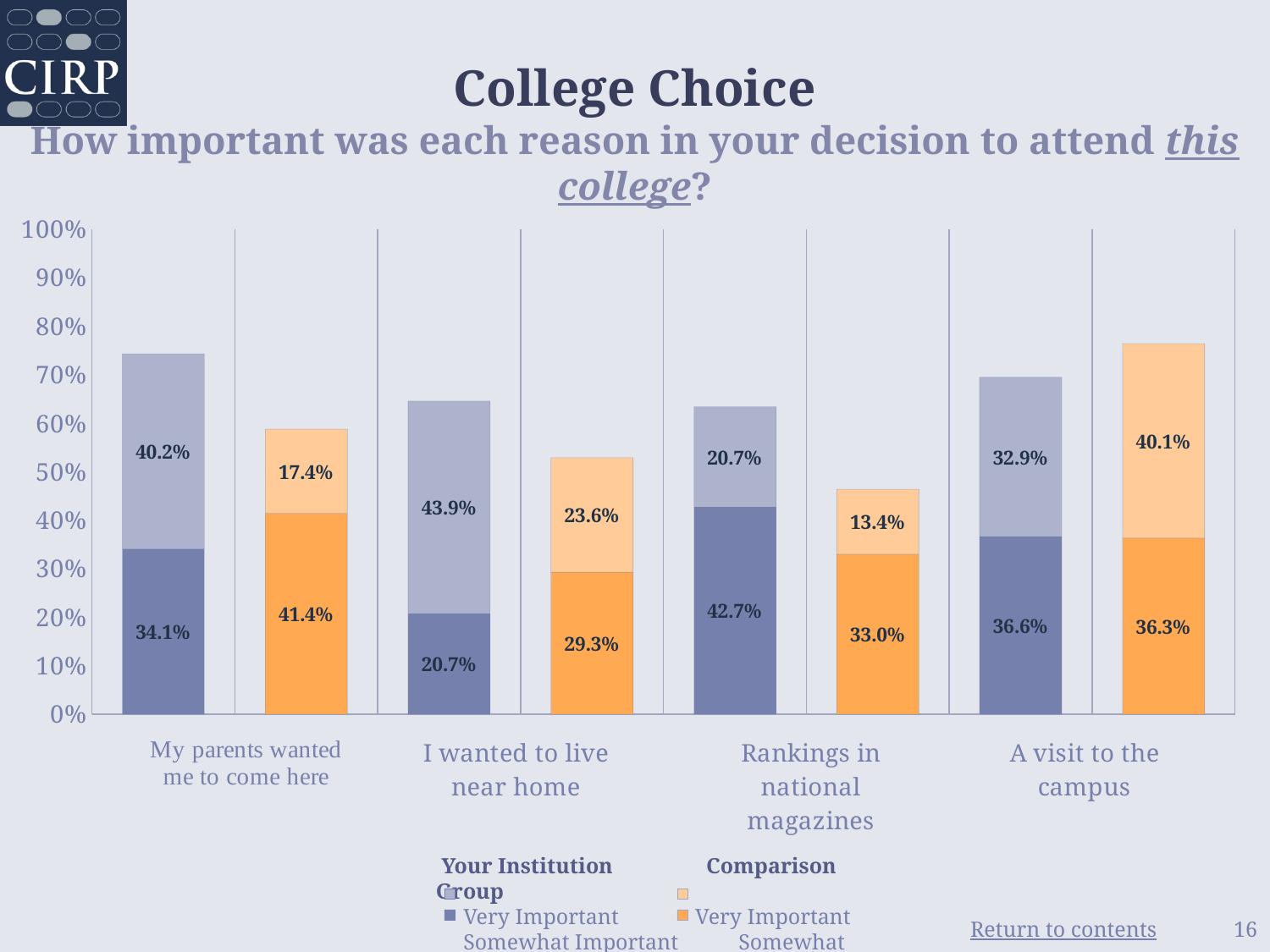
What percentage of Your Institution students rated "My parents wanted me to come here" as Very Important? 34.1% How many reasons (categories) are shown on the x axis? 4 What is the total stacked percentage (Very Important plus Somewhat Important) for Your Institution on "I wanted to live near home"? 64.6% Which reason has the lowest Somewhat Important percentage for the Comparison Group? Rankings in national magazines Which reason has the highest Very Important percentage for Your Institution? Rankings in national magazines What is the difference between the Comparison Group's and Your Institution's Very Important percentages for "My parents wanted me to come here"? 7.3% What percentage of Your Institution students rated "Rankings in national magazines" as Very Important? 42.7% What percentage of the Comparison Group rated "A visit to the campus" as Somewhat Important? 40.1% What is the total stacked percentage for the Comparison Group on "Rankings in national magazines"? 46.4% How many series does the legend list? 4 For "I wanted to live near home", which is larger: Your Institution's Somewhat Important percentage or the Comparison Group's Somewhat Important percentage? Your Institution's Somewhat Important percentage What type of chart is shown on the slide? Stacked bar chart